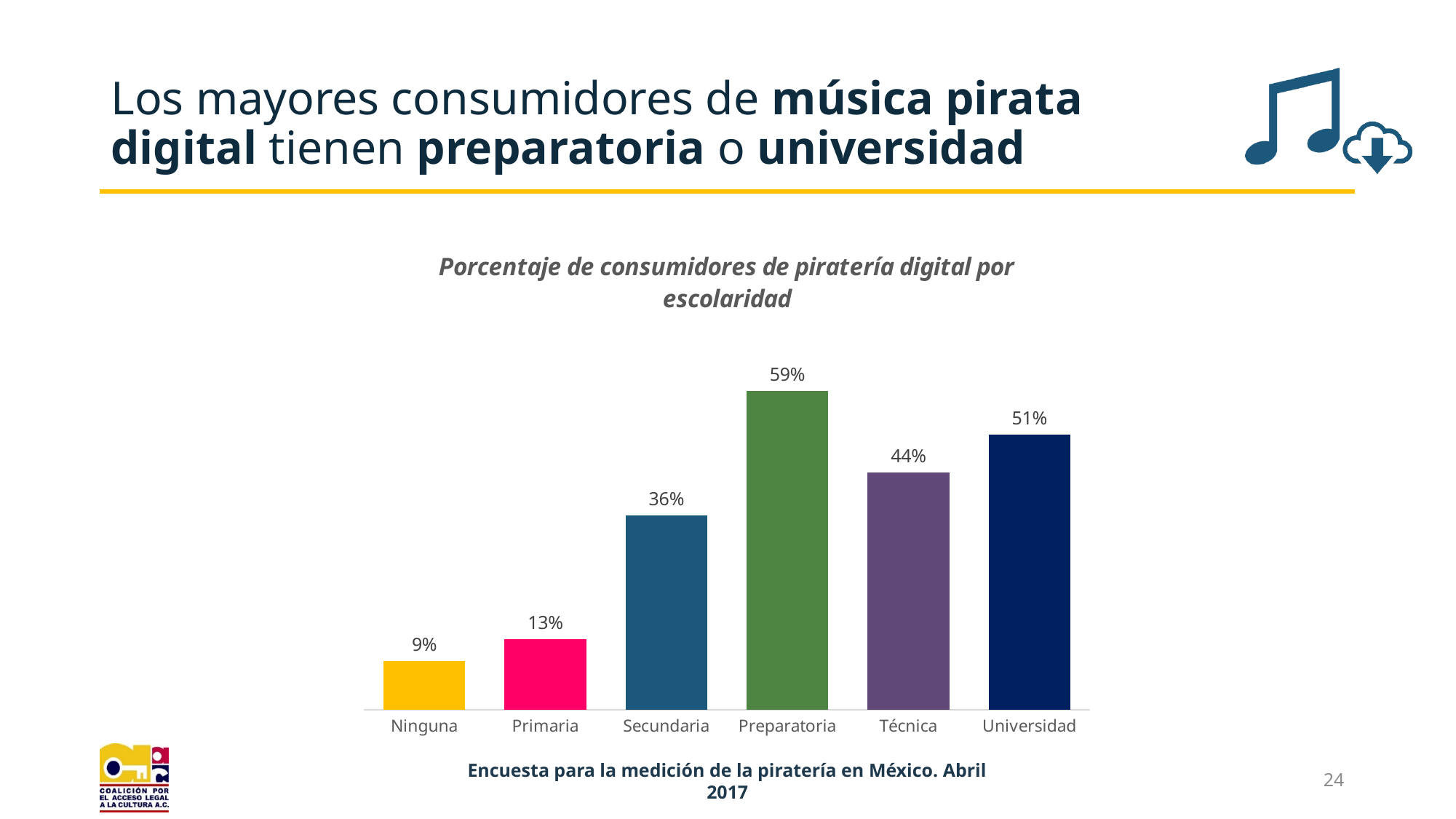
Which category has the lowest value? Ninguna What is the difference between the values for Preparatoria and Universidad? 8% Which is larger, the value for Técnica or the value for Universidad? Universidad How many categories are shown on the x axis? 6 What is the value for Preparatoria? 59% What is the value for Técnica? 44% What colour is the bar for Preparatoria? Green What kind of chart is shown on the slide? Bar chart Which category has the highest value? Preparatoria What is the difference between the values for Secundaria and Primaria? 23% What is the value for Ninguna? 9% What is the title of the chart? Porcentaje de consumidores de piratería digital por escolaridad